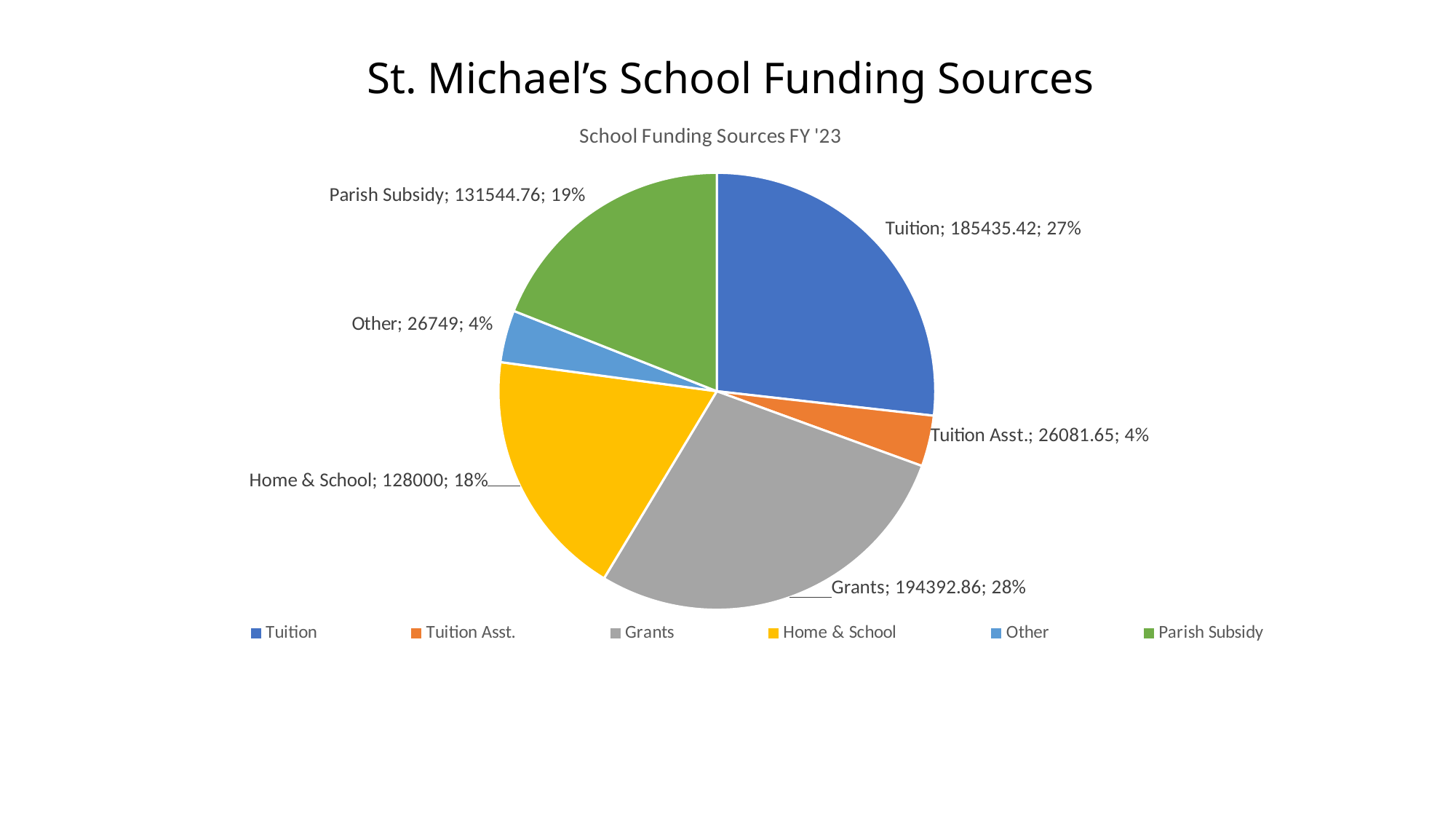
Which is larger, the value for Other or the value for Tuition Asst.? Other What is the value for Tuition? 185435.42 What type of chart is shown on the slide? Pie chart What share of the pie does Grants represent? 28% What is the title of the chart? School Funding Sources FY '23 What is the value for Parish Subsidy? 131544.76 Which funding source has the smallest value? Tuition Asst. How many funding sources are shown in the pie chart? 6 What is the difference between the Grants value and the Tuition value? 8957.44 What is the difference between the Parish Subsidy value and the Home & School value? 3544.76 What is the value for Home & School? 128000 Which funding source has the largest value? Grants